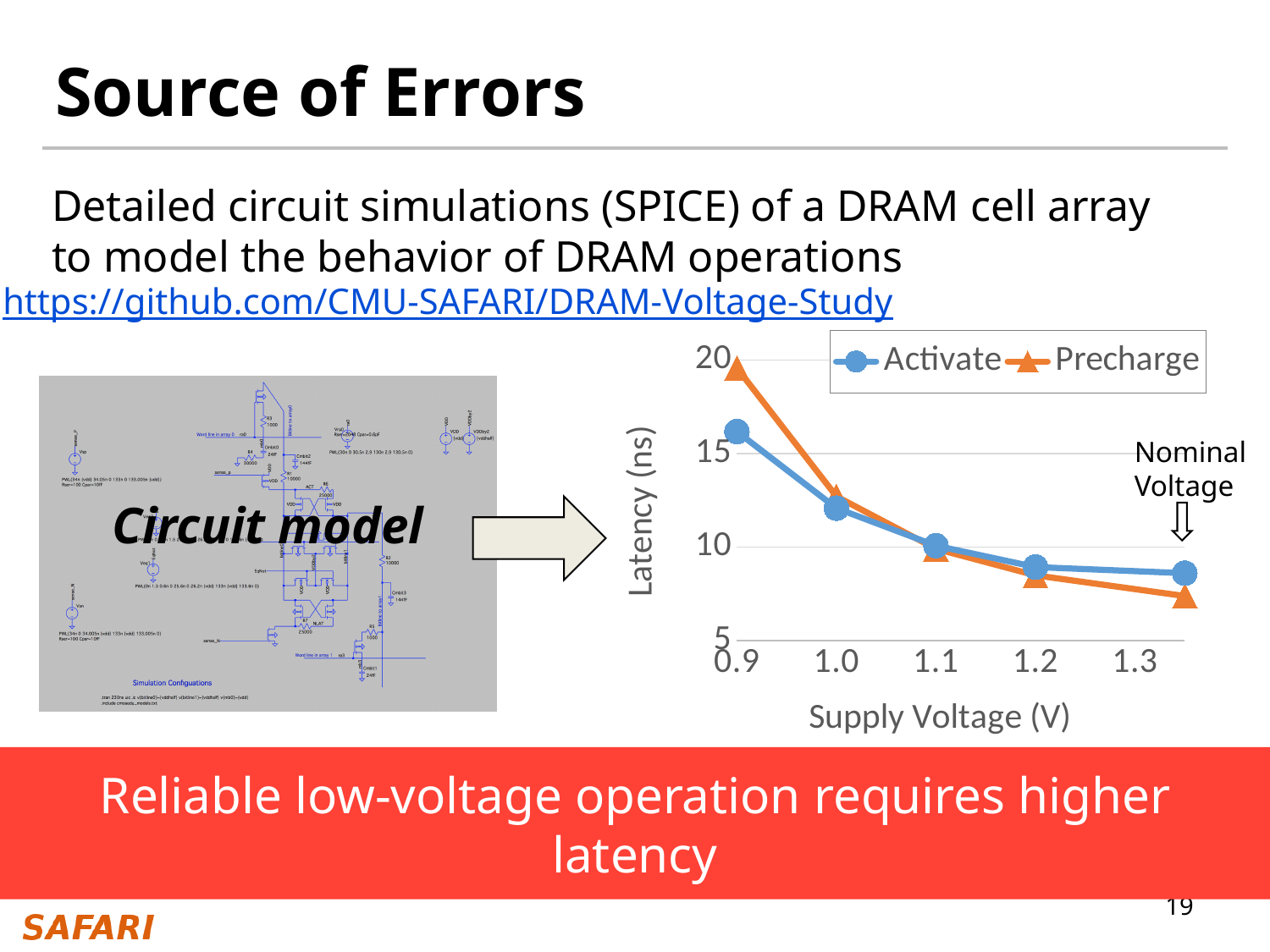
What are the two series named in the chart's legend? Activate and Precharge Is the Precharge latency at 0.9 V greater or less than 15 ns? greater Is the Precharge latency at the highest plotted voltage greater or less than 10 ns? less What is the label of the chart's y axis? Latency (ns) Is the Activate latency at 0.9 V greater or less than 15 ns? greater How many data points are plotted for the Activate series? 5 What kind of chart is shown on the slide? line chart Does latency rise or fall as supply voltage increases along the x axis? fall How many series does the chart's legend list? 2 At which supply voltage is the Precharge latency highest? 0.9 At 0.9 V, which series has the higher latency, Activate or Precharge? Precharge